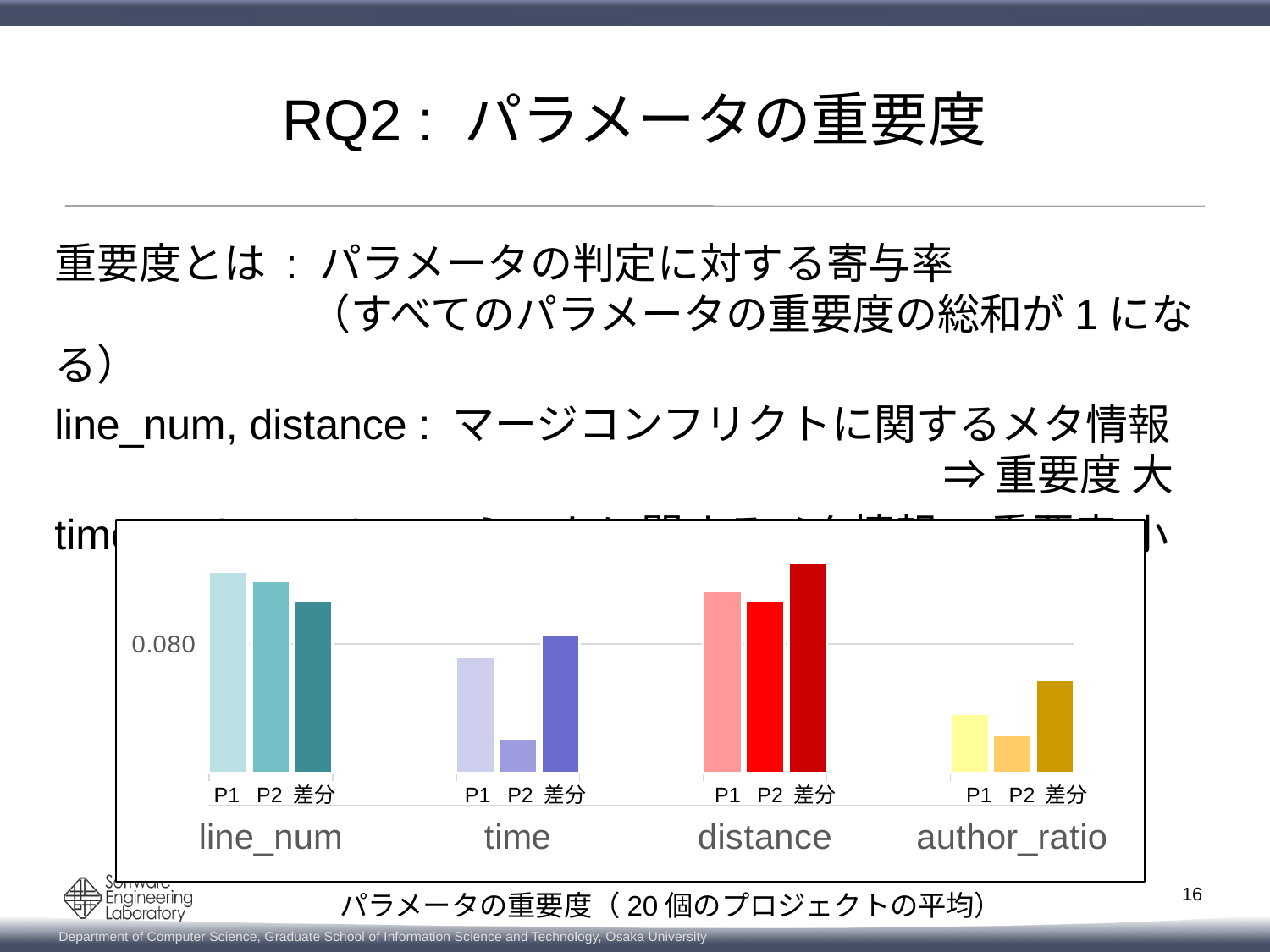
What kind of chart is shown on the slide? bar chart Is the value for 差分 of author_ratio greater or less than 0.080? less Which is larger, the P2 value for distance or the P2 value for time? distance What caption is shown below the chart? パラメータの重要度（20個のプロジェクトの平均） How many bars are shown in each parameter group of the chart? 3 How many parameter groups are shown along the x axis of the chart? 4 Is the value for P1 of line_num greater or less than 0.080? greater Is the value for P1 of time greater or less than 0.080? less Which bar is the highest in the whole chart? 差分 for distance Within the time group, which bar is the lowest? P2 Within the author_ratio group, which bar is the highest? 差分